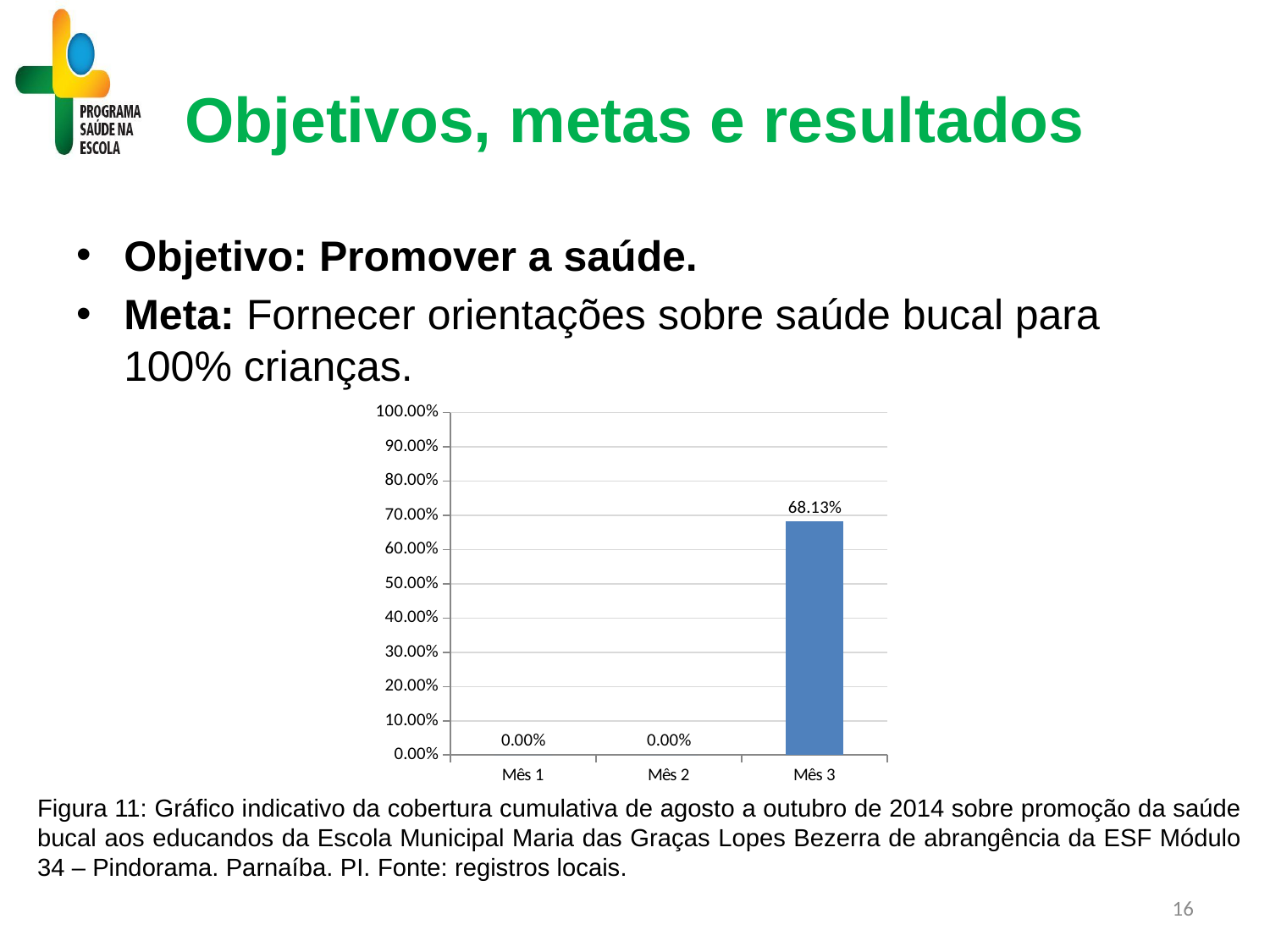
What is the value for Mês 2? 0.00% How many months are shown on the x axis? 3 What is the value for Mês 3? 68.13% What is the difference between the values for Mês 3 and Mês 2? 68.13% Which is larger, the value for Mês 3 or the value for Mês 1? Mês 3 What colour is the bar for Mês 3? blue What is the highest value shown on the y axis? 100.00% Which month has the highest value? Mês 3 Is the value for Mês 3 greater or less than 70.00%? less Do the values rise or fall from Mês 1 to Mês 3? rise What kind of chart is shown on the slide? bar chart What is the value for Mês 1? 0.00%